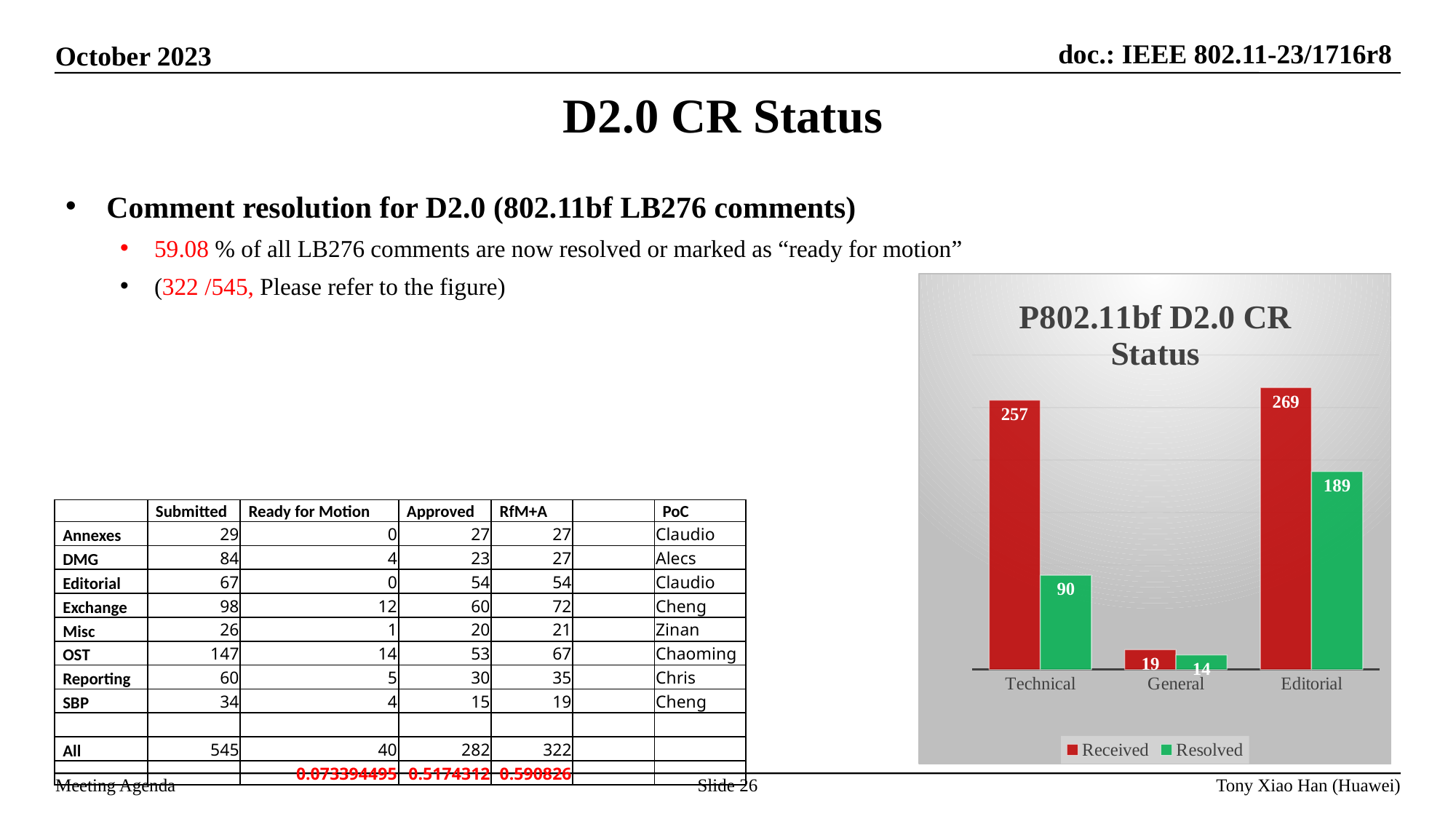
How many series does the chart legend list? 2 Which category has the lowest Resolved value in the chart? General What is the difference between Received and Resolved for Technical in the chart? 167 What is the Resolved value for Editorial in the chart? 189 What type of chart is the P802.11bf D2.0 CR Status chart? Bar chart What is the difference between Received and Resolved for Editorial in the chart? 80 What is the Received value for General in the chart? 19 Which category has the highest Received value in the chart? Editorial What is the Received value for Technical in the P802.11bf D2.0 CR Status chart? 257 Which is larger in the chart: the Resolved value for Editorial or the Resolved value for Technical? Resolved value for Editorial How many categories are shown on the x axis of the chart? 3 What is the Resolved value for Technical in the chart? 90